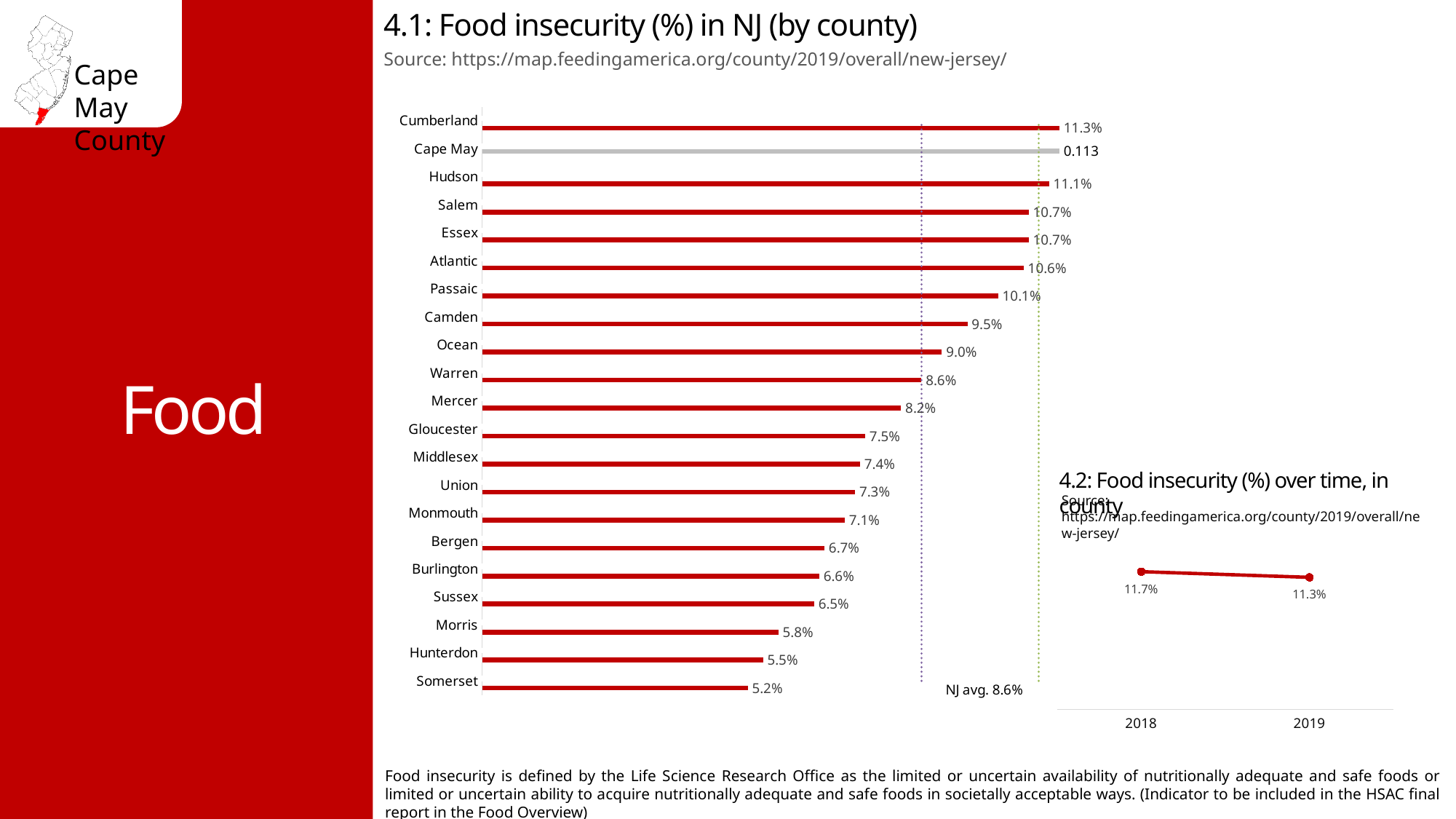
In chart 4.1 (Food insecurity in NJ by county), what is the difference between Camden and Ocean? 0.5% In chart 4.1 (Food insecurity in NJ by county), what NJ average value is labelled on the chart? NJ avg. 8.6% In chart 4.1 (Food insecurity in NJ by county), what is the value for Somerset? 5.2% In chart 4.2 (Food insecurity over time in county), what is the value for 2018? 11.7% In chart 4.1 (Food insecurity in NJ by county), which county has the lowest value? Somerset What kind of chart is chart 4.1 (Food insecurity in NJ by county)? Bar chart In chart 4.2 (Food insecurity over time in county), does the value rise or fall from 2018 to 2019? Fall In chart 4.2 (Food insecurity over time in county), what is the difference between the 2018 and 2019 values? 0.4% In chart 4.1 (Food insecurity in NJ by county), which is larger, the value for Passaic or the value for Mercer? Passaic In chart 4.1 (Food insecurity in NJ by county), what is the value for Hudson? 11.1% In chart 4.1 (Food insecurity in NJ by county), how many counties are shown? 21 In chart 4.1 (Food insecurity in NJ by county), what label is printed next to the Cape May bar? 0.113